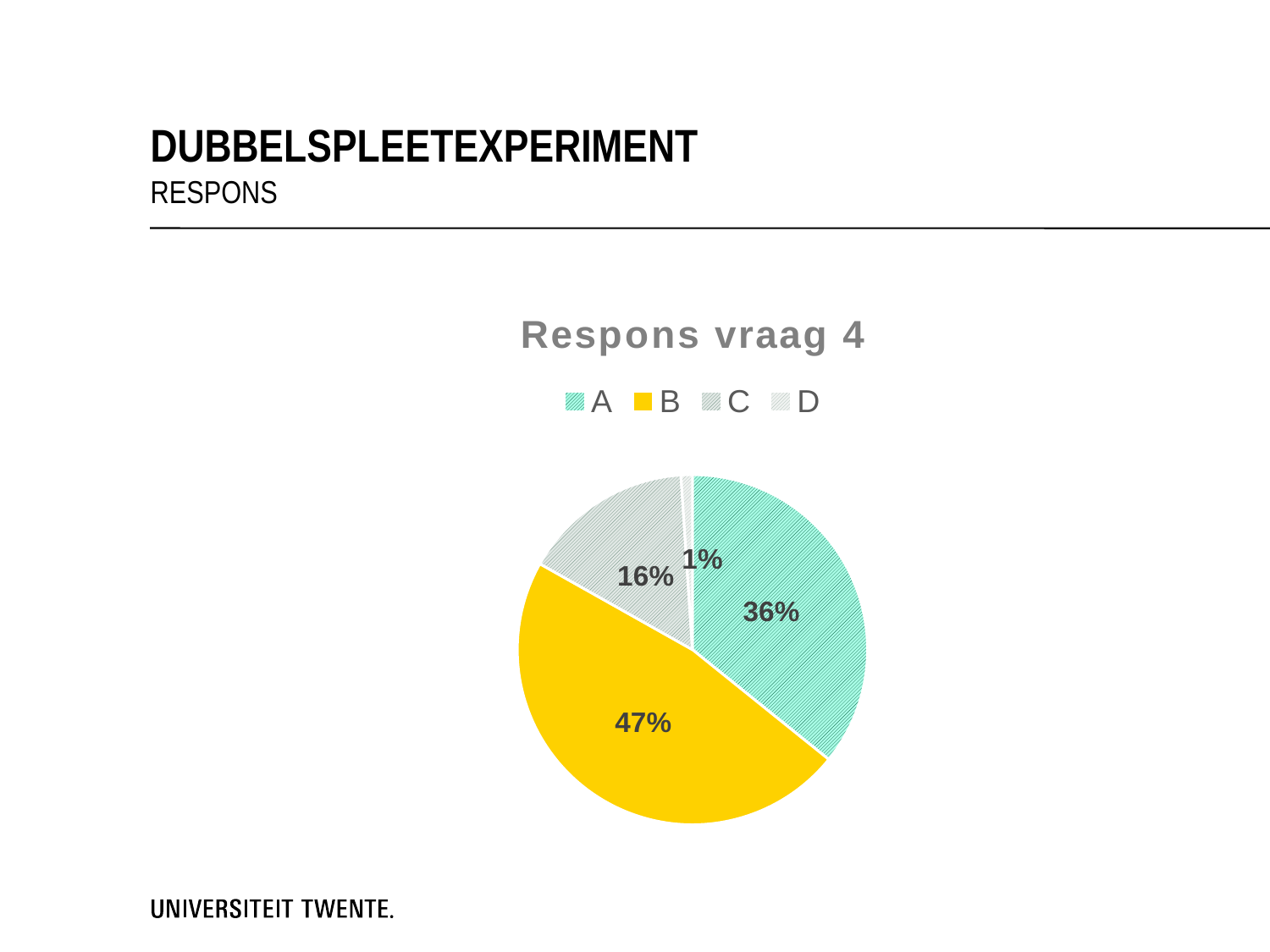
Which category has the smallest slice of the pie? D What share of the pie does category A have? 36% What kind of chart is shown on the slide? Pie chart What is the difference in percentage points between the shares of B and A? 11% How many categories does the pie chart show? 4 Which has a larger share, A or C? A What share of the pie does category B have? 47% What share of the pie does category D have? 1% What is the title of the chart? Respons vraag 4 Which category has the largest slice of the pie? B What is the difference in percentage points between the shares of A and C? 20%